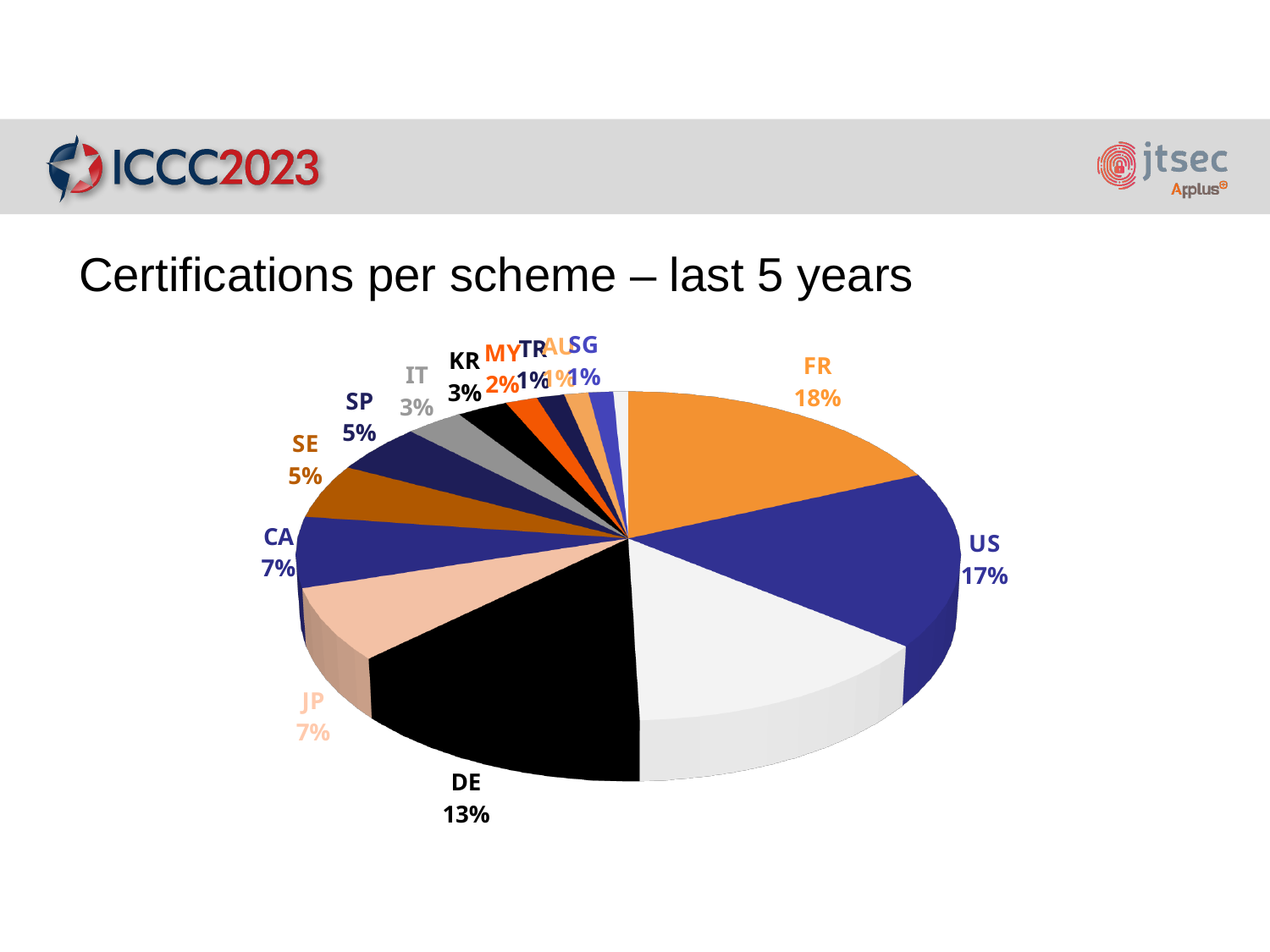
What percentage is shown for MY? 2% What percentage is shown for IT? 3% Which has the larger share, FR or US? FR What percentage is shown for JP? 7% What is the title of the chart? Certifications per scheme – last 5 years What percentage is shown for SE? 5% What kind of chart is shown on the slide? pie chart What share of certifications does FR have? 18% What is the difference in percentage points between US and CA? 10 What is the difference in percentage points between FR and DE? 5 What share of certifications does US have? 17% What percentage is shown for DE? 13%